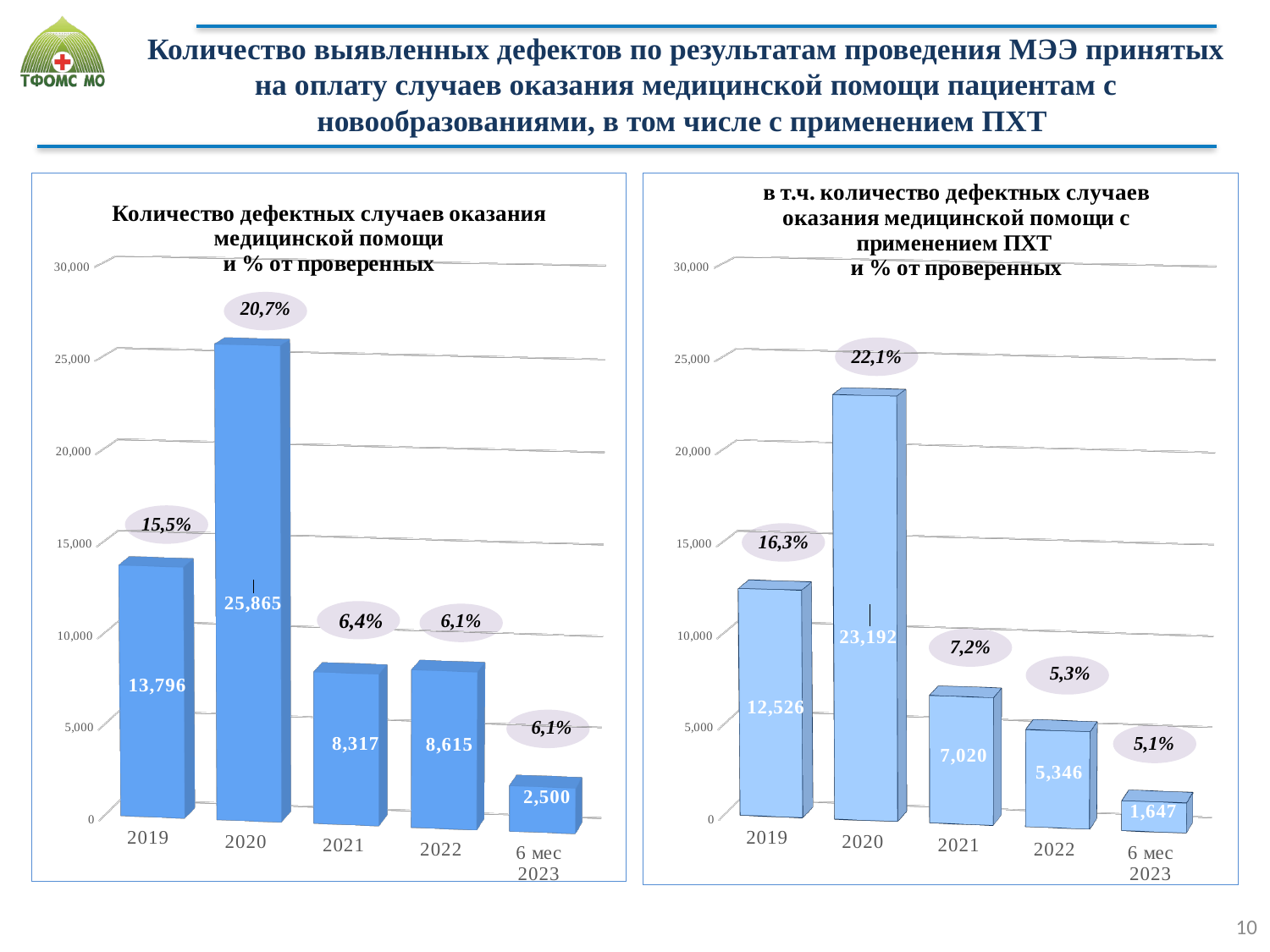
In the right chart, what is the value for 2022? 5,346 In the right chart, what is the difference between the values for 2020 and 2019? 10,666 In the left chart, what is the value for 2020? 25,865 In the right chart, what is the value for 2019? 12,526 In the right chart, which category has the lowest value? 6 мес 2023 How many bars are shown in the left chart? 5 What type of chart is the right chart? bar chart In the right chart, which is larger, the value for 2021 or the value for 2022? 2021 In the left chart, what is the difference between the values for 2022 and 2021? 298 In the left chart, which year has the highest value? 2020 In the left chart, what is the value for 6 мес 2023? 2,500 In the left chart, what percentage label is shown above the 2020 bar? 20,7%